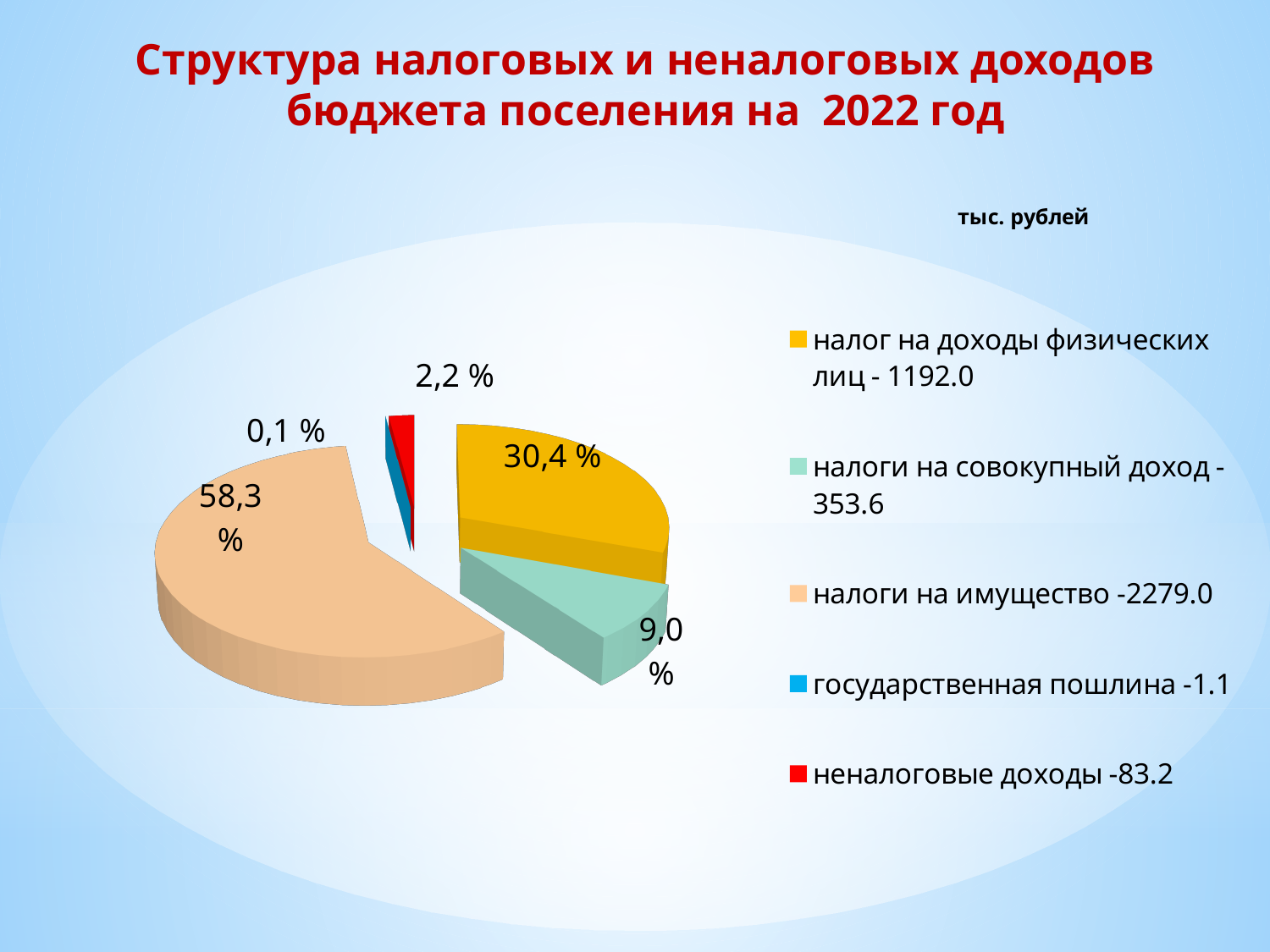
What share of the pie does "неналоговые доходы" represent? 2,2 % Which category has the largest share of the pie? налоги на имущество What colour is the slice for "неналоговые доходы"? red What is the difference in percentage points between the share for "налоги на имущество" and the share for "налог на доходы физических лиц"? 27,9 % What kind of chart is shown on the slide? pie chart According to the legend, what amount in thousand rubles is given for "государственная пошлина"? 1.1 Which category has the smallest share of the pie? государственная пошлина How many slices does the pie chart have? 5 What share of the pie does "налоги на имущество" represent? 58,3 % What share of the pie does "налог на доходы физических лиц" represent? 30,4 % Which is larger: the share for "налог на доходы физических лиц" or the share for "налоги на совокупный доход"? налог на доходы физических лиц